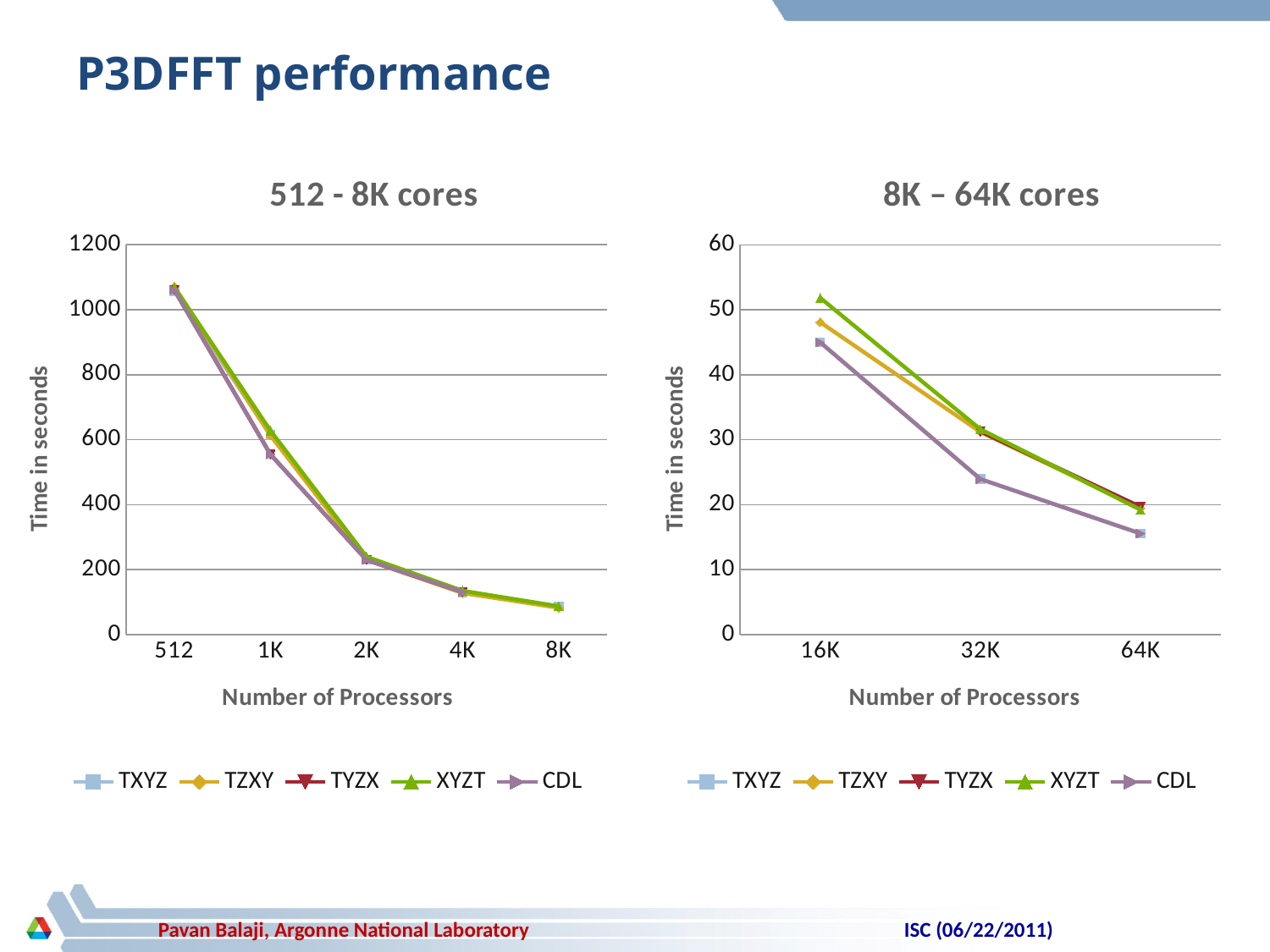
What kind of chart is the "512 - 8K cores" chart? line chart How many series does the legend of the "8K – 64K cores" chart list? 5 What is the y-axis label of the "8K – 64K cores" chart? Time in seconds In the "8K – 64K cores" chart, which series has the highest time at 16K processors? XYZT In the "512 - 8K cores" chart, is the value for CDL at 1K processors greater or less than 600? less In the "8K – 64K cores" chart, is the value for CDL at 32K processors greater or less than 30? less In the "512 - 8K cores" chart, is the value for XYZT at 512 processors greater or less than 1000? greater In the "512 - 8K cores" chart, do the times rise or fall as the number of processors increases? fall In the "8K – 64K cores" chart, which series has the lowest time at 64K processors? TXYZ and CDL (tied) How many processor counts are shown on the x axis of the "8K – 64K cores" chart? 3 How many processor counts are shown on the x axis of the "512 - 8K cores" chart? 5